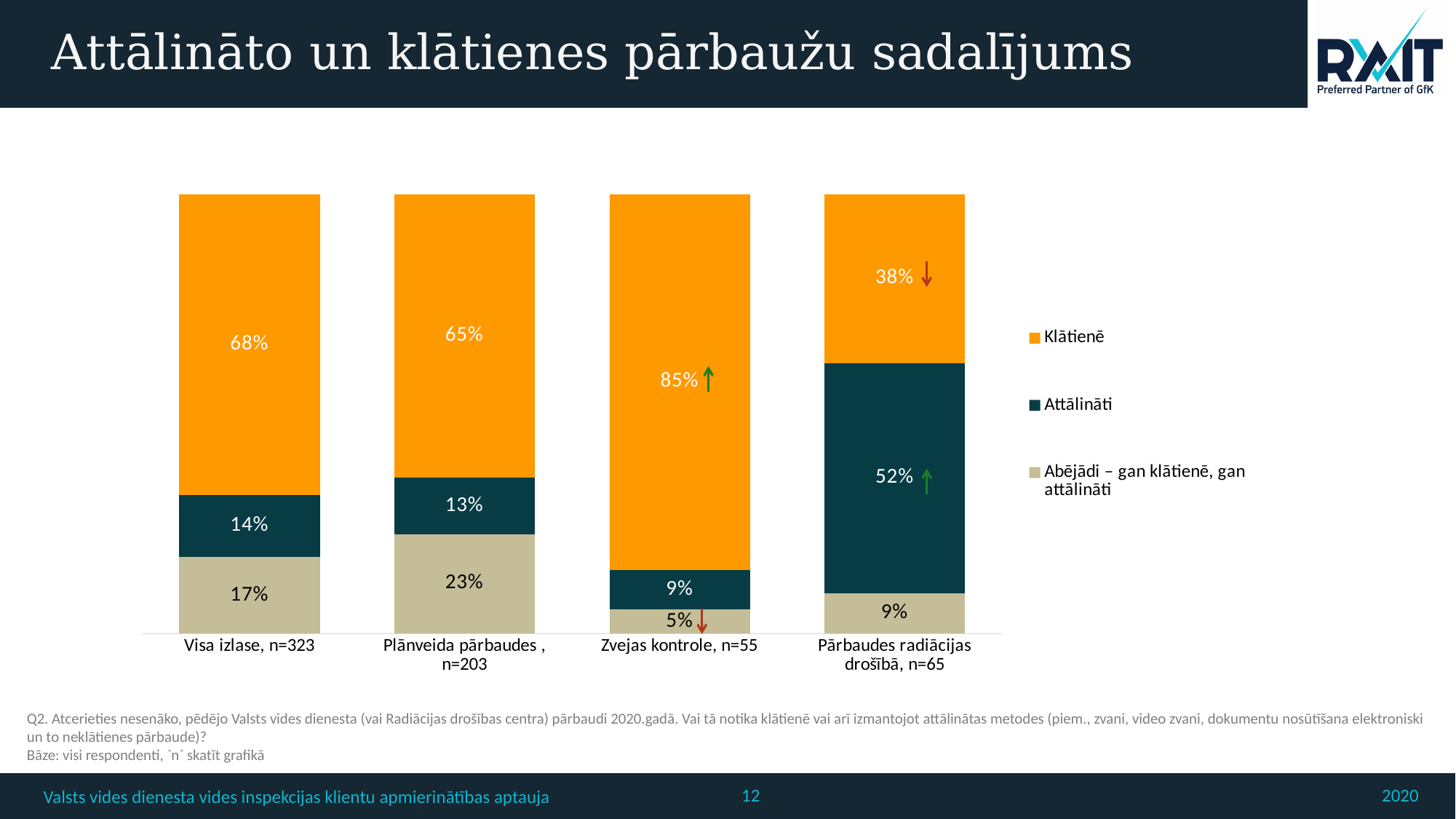
What type of chart is shown on the slide? Stacked bar chart Which category has the lowest Abējādi – gan klātienē, gan attālināti value? Zvejas kontrole, n=55 What is the Attālināti value for Visa izlase, n=323? 14% What is the Abējādi – gan klātienē, gan attālināti value for Plānveida pārbaudes, n=203? 23% Which category has the highest Klātienē value? Zvejas kontrole, n=55 What is the difference between the Klātienē values for Visa izlase, n=323 and Pārbaudes radiācijas drošībā, n=65? 30% What is the Klātienē value for Zvejas kontrole, n=55? 85% How many categories (bars) are shown on the x axis? 4 What is the Attālināti value for Pārbaudes radiācijas drošībā, n=65? 52% How many series does the legend list? 3 Which is larger for Pārbaudes radiācijas drošībā, n=65: the Klātienē value or the Attālināti value? Attālināti Which legend entry is shown in orange? Klātienē